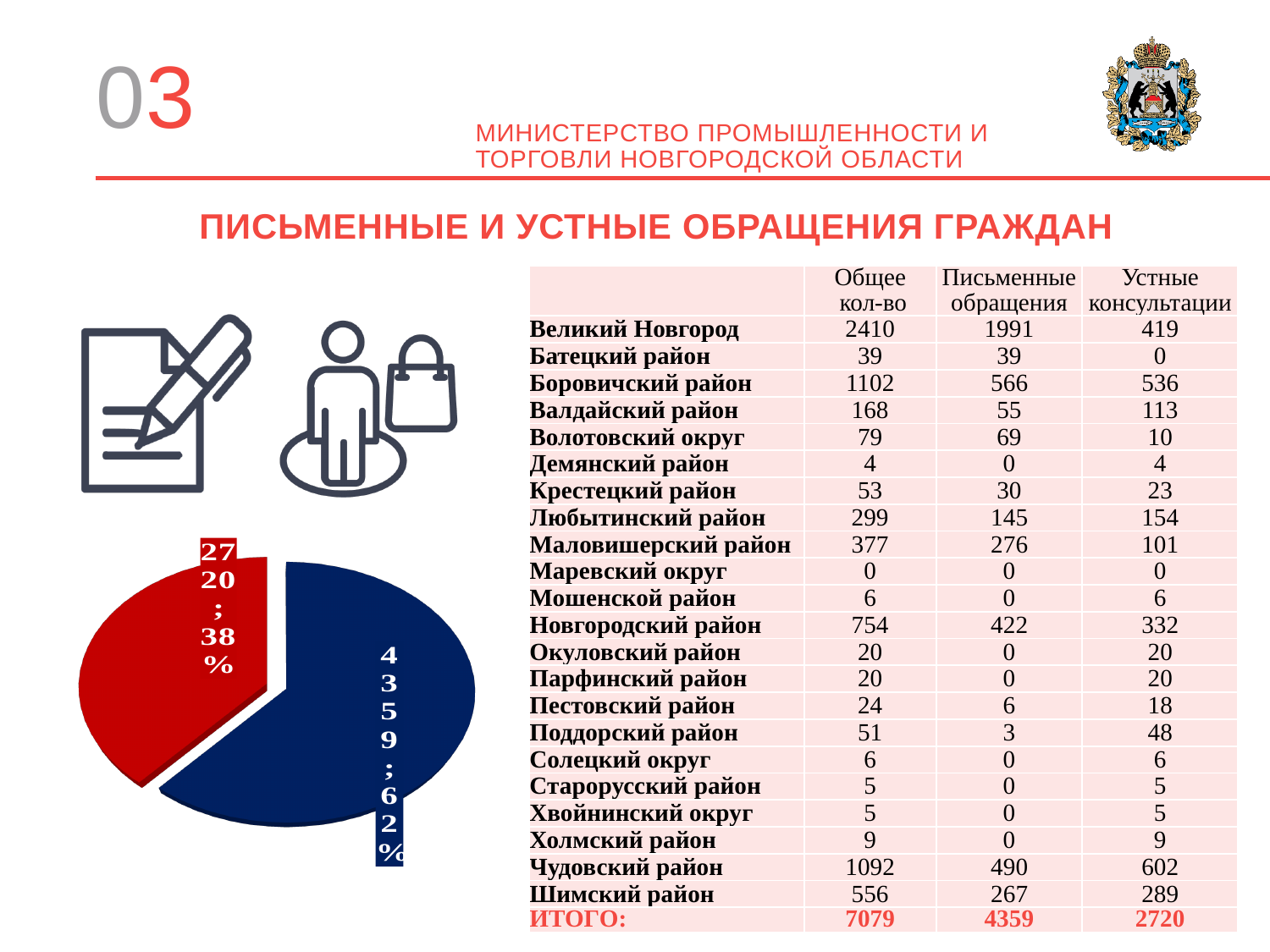
Which slice of the pie chart is the smallest? The red slice (2720; 38%) Is the value of the blue slice larger or smaller than the value of the red slice? Larger What value is printed on the red slice of the pie chart? 2720 What share of the pie does the blue slice represent? 62% What is the total of the two values shown on the pie chart? 7079 What value is printed on the blue slice of the pie chart? 4359 Which slice of the pie chart is the largest? The blue slice (4359; 62%) What kind of chart is shown on the left of the slide? Pie chart What two colours are used for the slices of the pie chart? Blue and red What share of the pie does the red slice represent? 38% How many slices does the pie chart have? 2 What is the difference between the values of the blue and red slices of the pie chart? 1639